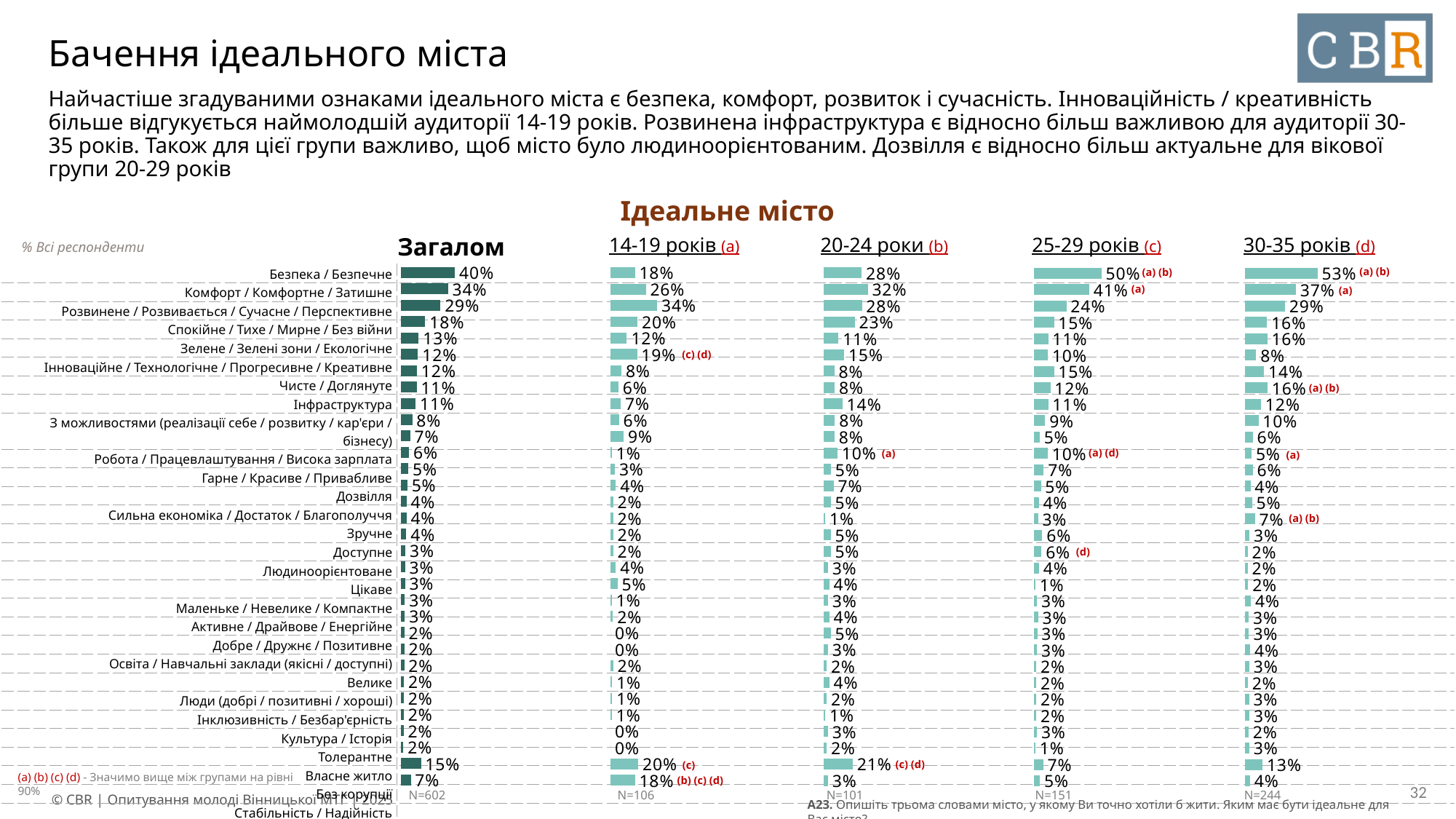
What is the value for "Безпека / Безпечне" in the "14-19 років (a)" column? 18% Which category has the highest value in the "Загалом" column? Безпека / Безпечне For "Безпека / Безпечне", which age group has the larger value: 25-29 років or 20-24 роки? 25-29 років What is the value for "Безпека / Безпечне" in the "Загалом" column? 40% What is the value for "Комфорт / Комфортне / Затишне" in the "Загалом" column? 34% What is the title of the chart? Ідеальне місто What is the value for "Безпека / Безпечне" in the "30-35 років (d)" column? 53% What is the sample size (N) shown for the "30-35 років (d)" column? N=244 How many age-group columns (excluding "Загалом") are shown in the chart? 4 What kind of chart is used on this slide? Bar chart What is the difference between the "Безпека / Безпечне" values for 30-35 років and 14-19 років? 35 percentage points What is the value for "Розвинене / Розвивається / Сучасне / Перспективне" in the "14-19 років (a)" column? 34%